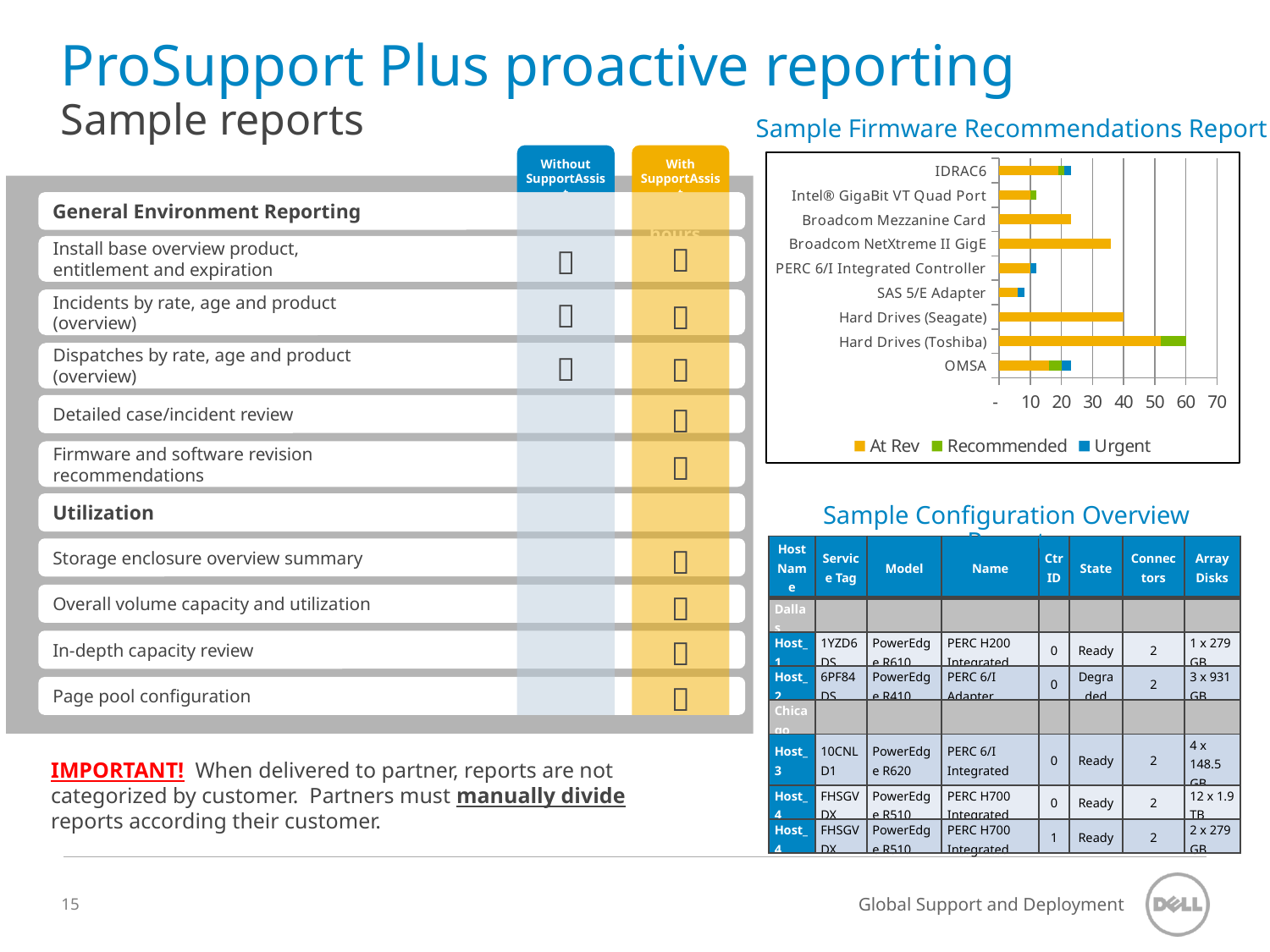
In the Sample Firmware Recommendations Report chart, which component has the shortest total bar? SAS 5/E Adapter In the Sample Firmware Recommendations Report chart, is the total value for Broadcom NetXtreme II GigE greater or less than 30? greater How many series does the legend of the Sample Firmware Recommendations Report chart list? 3 In the Sample Firmware Recommendations Report chart, is the total value for Intel® GigaBit VT Quad Port greater or less than 20? less What kind of chart is the Sample Firmware Recommendations Report? bar chart In the Sample Firmware Recommendations Report chart, is the total value for Hard Drives (Toshiba) greater or less than 50? greater What are the three series named in the legend of the Sample Firmware Recommendations Report chart? At Rev, Recommended, Urgent How many components are listed on the y axis of the Sample Firmware Recommendations Report chart? 9 In the Sample Firmware Recommendations Report chart, which has the larger total bar: Hard Drives (Toshiba) or Hard Drives (Seagate)? Hard Drives (Toshiba) In the Sample Firmware Recommendations Report chart, which has the larger total bar: Broadcom NetXtreme II GigE or Broadcom Mezzanine Card? Broadcom NetXtreme II GigE In the Sample Firmware Recommendations Report chart, which component has the longest total bar? Hard Drives (Toshiba)